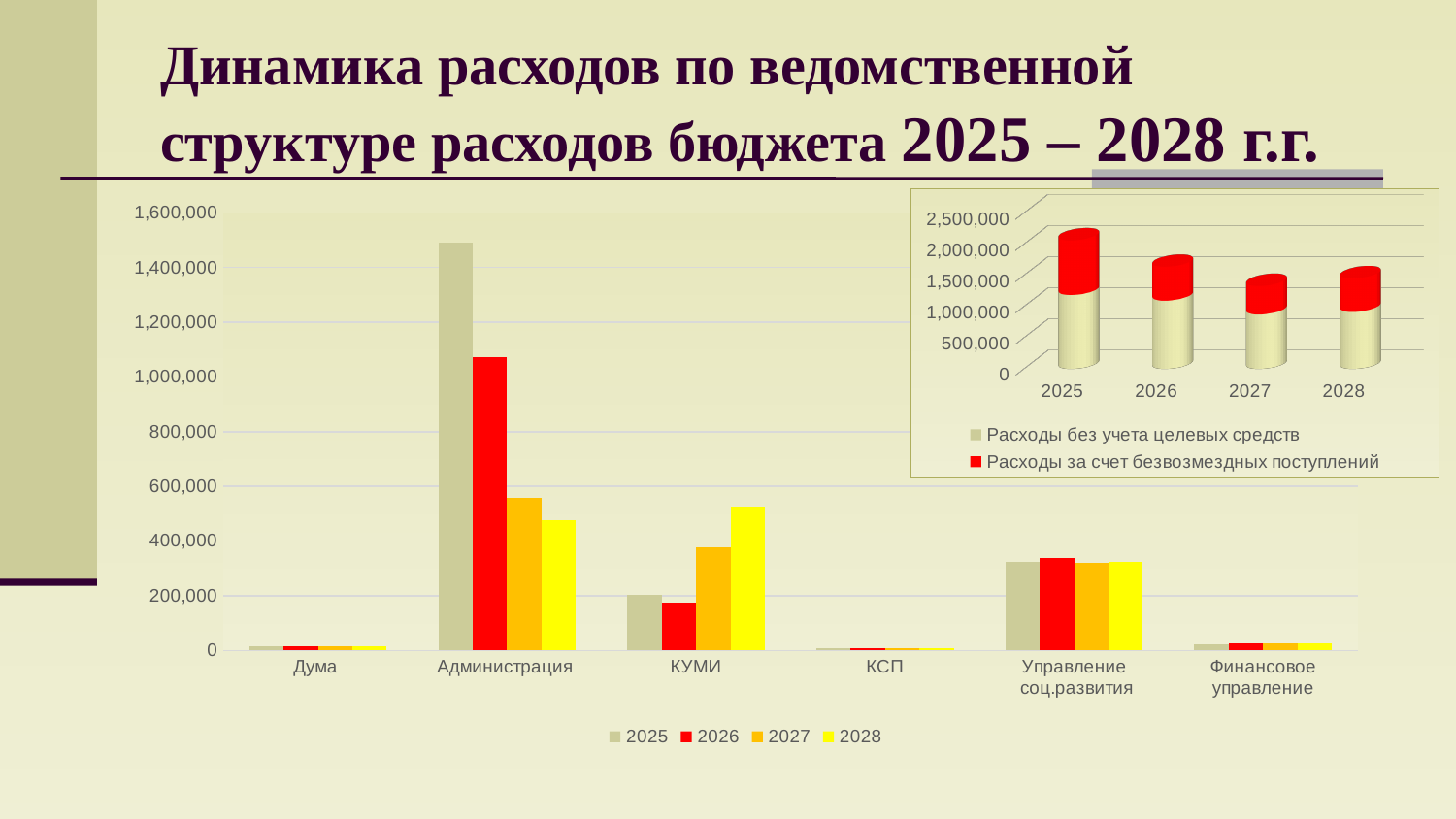
In the large chart on the left, which category has the tallest bar for 2025? Администрация How many categories are shown on the x axis of the large chart on the left? 6 How many series does the legend of the large chart on the left list? 4 How many series does the legend of the small inset chart in the top right list? 2 In the large chart on the left, do the values for Администрация rise or fall from 2025 to 2028? fall In the large chart on the left, what colour represents the 2026 series? red In the large chart on the left, is the 2025 value for Администрация greater or less than 1,400,000? greater In the small inset chart in the top right, which year has the tallest stacked bar? 2025 In the large chart on the left, which is larger for КУМИ: the 2025 value or the 2028 value? 2028 In the large chart on the left, is the 2026 value for Администрация greater or less than 1,000,000? greater What kind of chart is the large chart on the left of the slide? bar chart